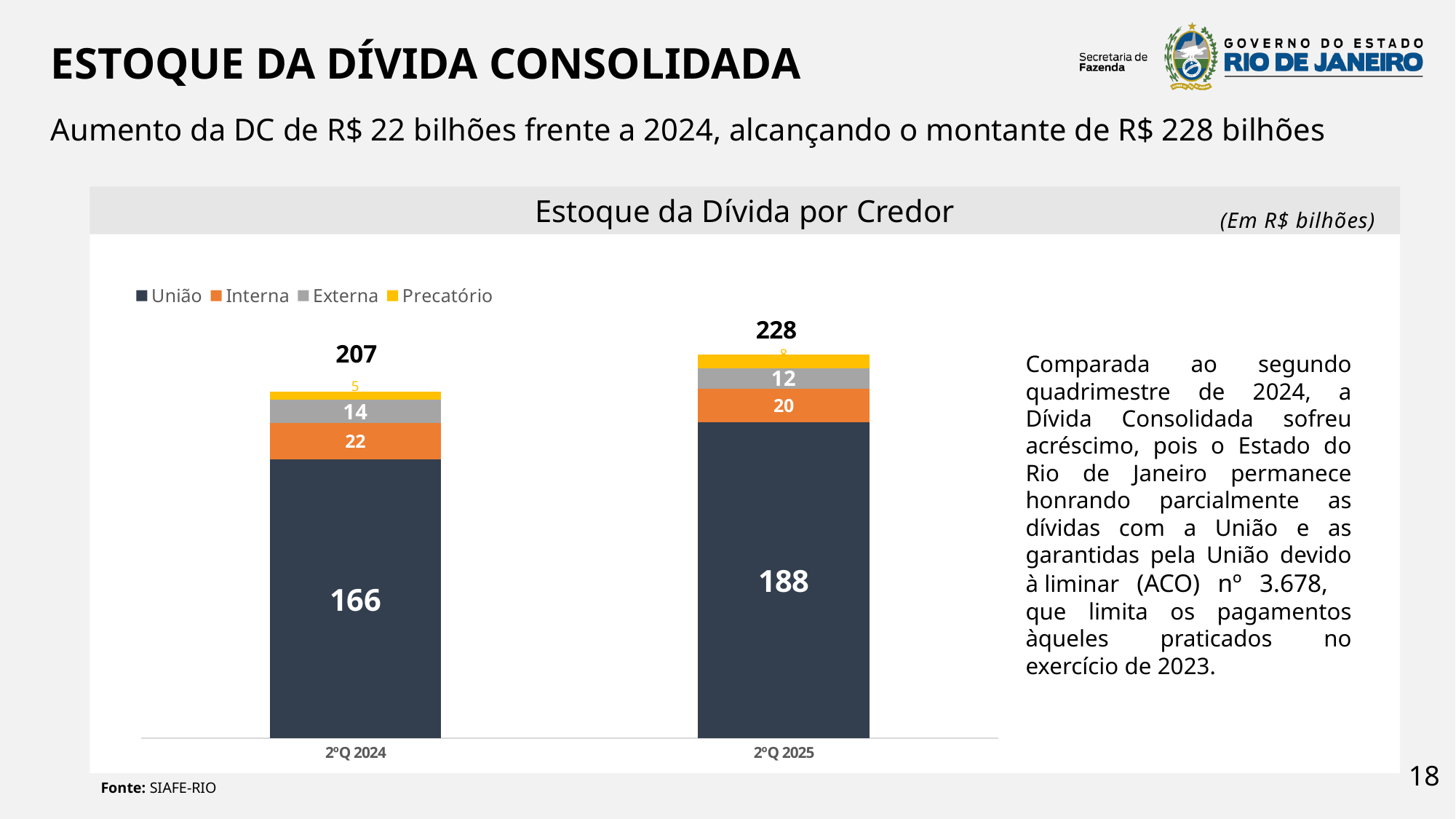
What is the title of the chart? Estoque da Dívida por Credor What kind of chart is shown on the slide? Stacked bar chart What is the total of the stacked bar for 2ºQ 2024? 207 Which period has the larger Interna value, 2ºQ 2024 or 2ºQ 2025? 2ºQ 2024 How many series does the legend list? 4 What is the value for União in 2ºQ 2025? 188 What is the value for Precatório in 2ºQ 2024? 5 Which series has the highest value in 2ºQ 2024? União What is the value for Externa in 2ºQ 2025? 12 What is the total of the stacked bar for 2ºQ 2025? 228 What is the difference between the União values for 2ºQ 2025 and 2ºQ 2024? 22 What is the value for Interna in 2ºQ 2024? 22